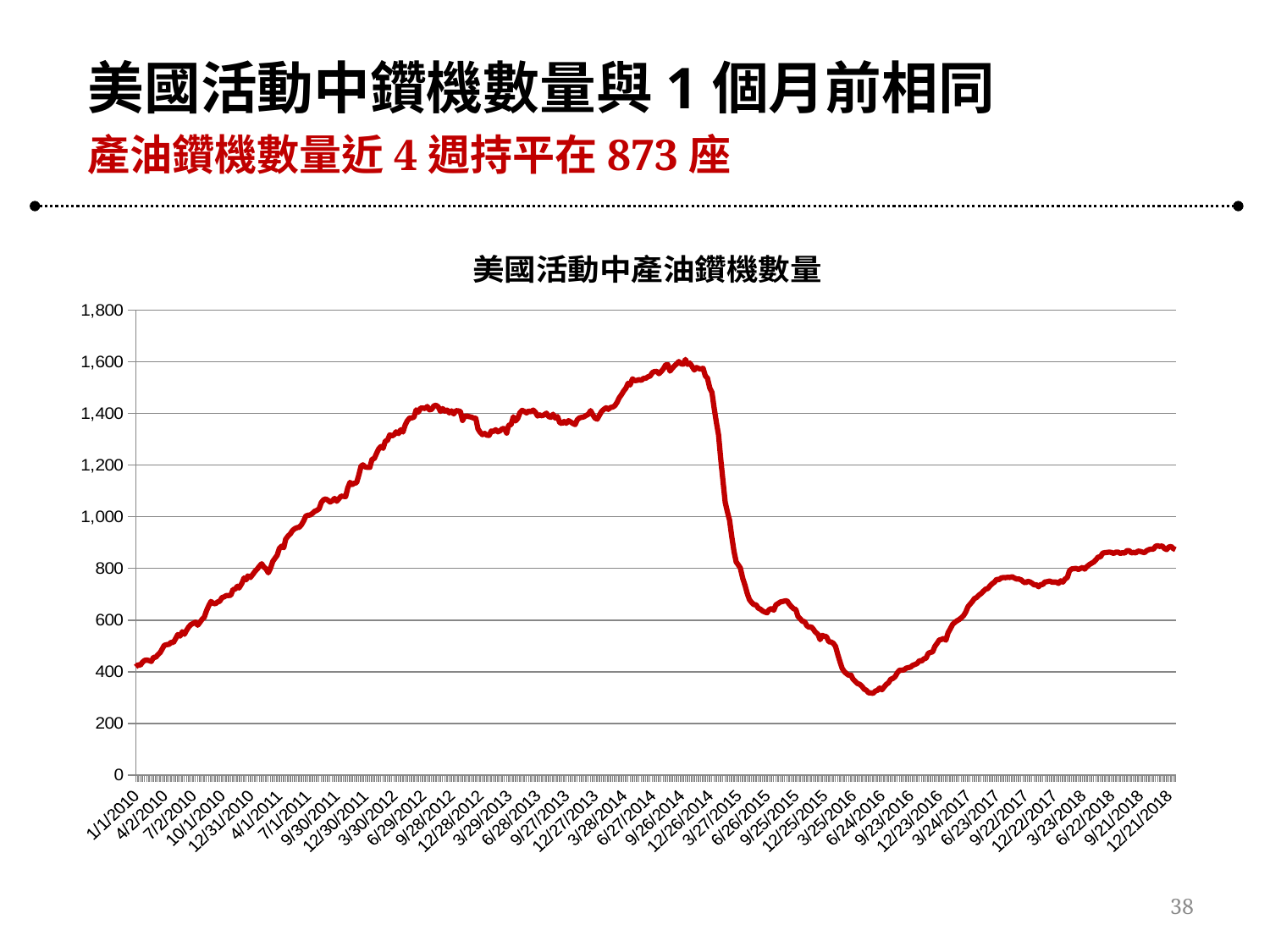
Is the value at 9/26/2014 greater or less than 1,400? greater Does the line rise or fall between 9/26/2014 and 6/24/2016? falls Is the value at 6/24/2016 greater or less than 400? less What is the highest value shown on the y axis? 1,800 Which is higher, the value at 6/29/2012 or the value at 6/24/2016? 6/29/2012 Is the value at 1/1/2010 greater or less than 600? less What kind of chart is shown on the slide? line chart Does the line rise or fall between 1/1/2010 and 9/26/2014? rises What is the title of the chart? 美國活動中產油鑽機數量